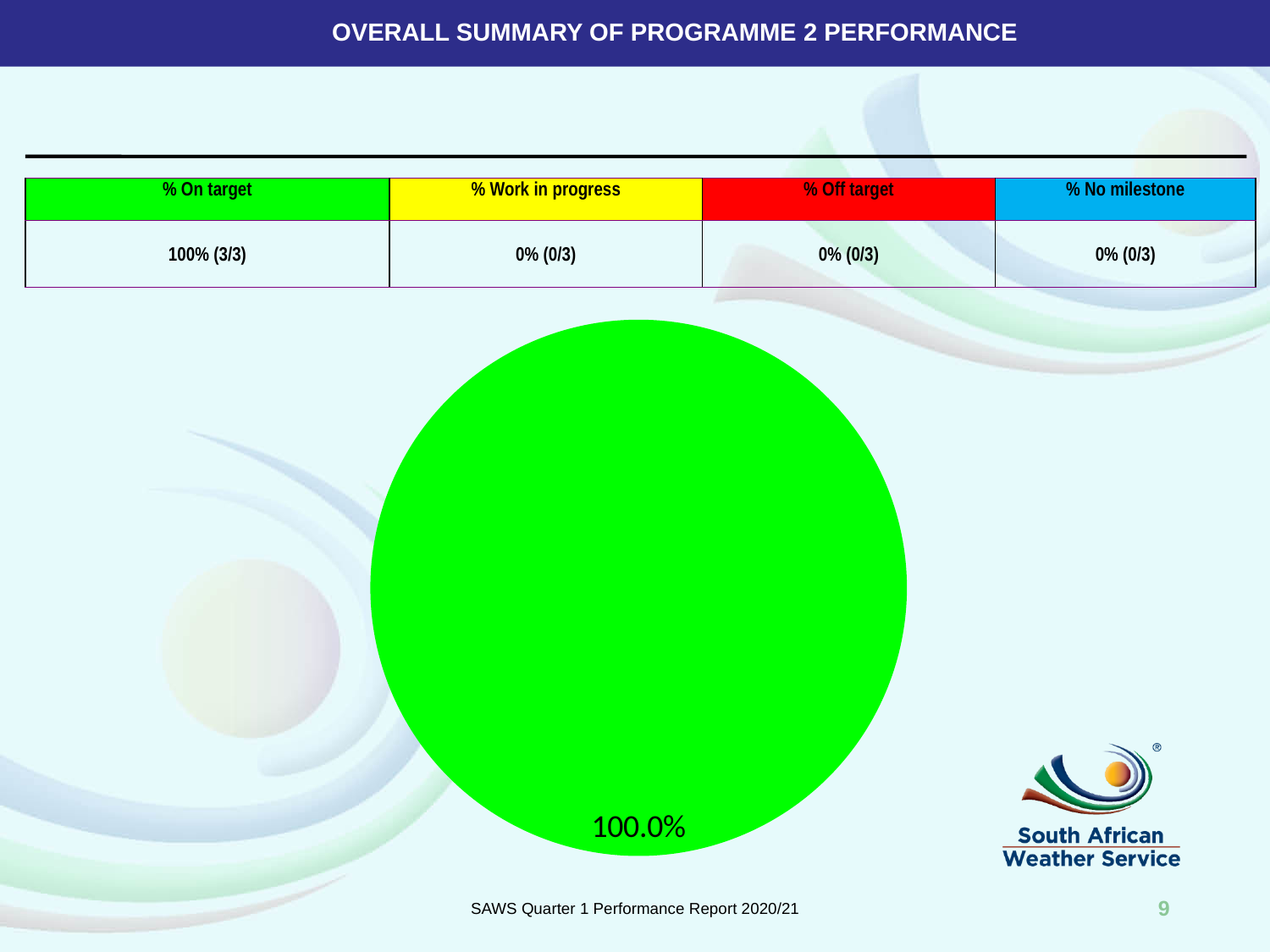
Is the value shown on the pie chart's data label greater or less than 50%? greater What share of the pie does the green slice represent? 100.0% What kind of chart is shown on the slide? pie chart What colour is the single slice of the pie chart? green What value is printed as the data label on the pie chart? 100.0% According to the colour key in the table above the chart, which category does the green slice of the pie represent? % On target How many slices are visible in the pie chart? 1